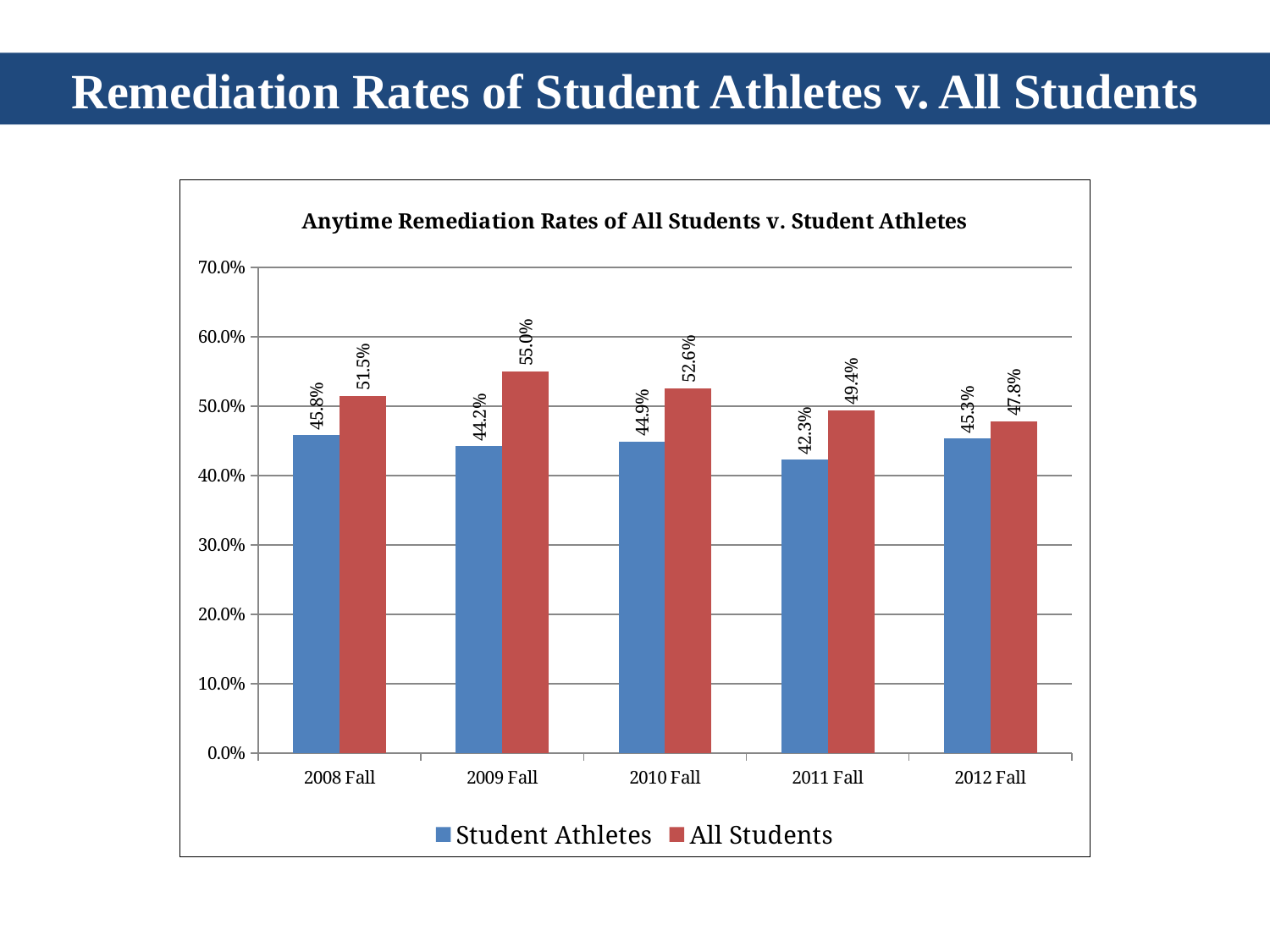
In which term is the Student Athletes remediation rate lowest? 2011 Fall What is the remediation rate for Student Athletes in 2011 Fall? 42.3% How many terms are shown on the x axis? 5 Which is larger in 2012 Fall, the Student Athletes rate or the All Students rate? All Students How many series does the legend list? 2 What is the title of the chart? Anytime Remediation Rates of All Students v. Student Athletes What is the remediation rate for All Students in 2009 Fall? 55.0% Is the Student Athletes remediation rate in 2010 Fall greater or less than 50.0%? less What is the remediation rate for Student Athletes in 2008 Fall? 45.8% In which term is the All Students remediation rate highest? 2009 Fall What is the difference between the All Students and Student Athletes remediation rates in 2009 Fall? 10.8% What kind of chart is shown on the slide? Bar chart